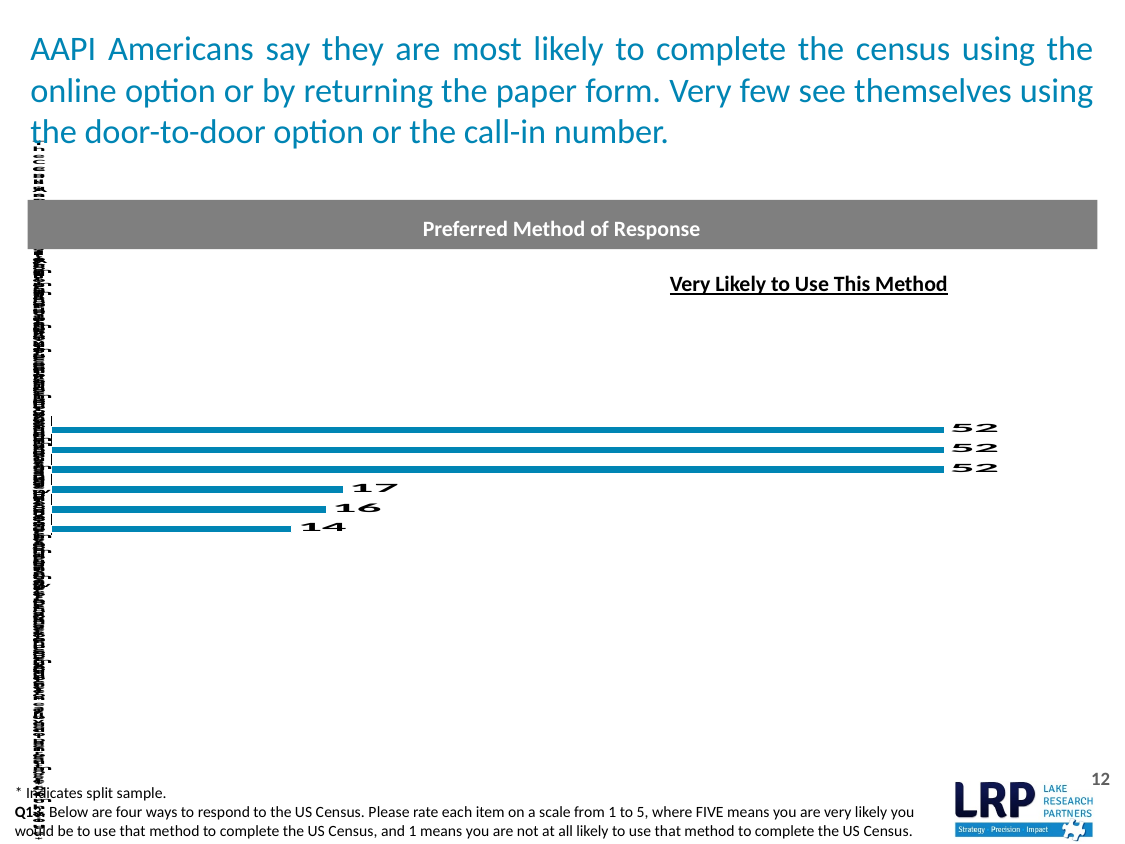
What is the value labelled on the top bar of the chart? 52 What is the title shown in the grey header bar above the chart? Preferred Method of Response What is the highest value shown on any bar in the chart? 52 How many bars are plotted in the chart? 6 What is the value labelled on the fifth bar from the top? 16 How many bars in the chart are labelled 52? 3 What is the difference between the highest bar value (52) and the lowest bar value (14)? 38 What is the value labelled on the bottom bar of the chart? 14 What kind of chart is shown under the heading "Preferred Method of Response"? bar chart What is the value labelled on the fourth bar from the top? 17 Which is larger: the fourth bar from the top (17) or the bottom bar (14)? the fourth bar from the top (17) What is the lowest value shown on any bar in the chart? 14